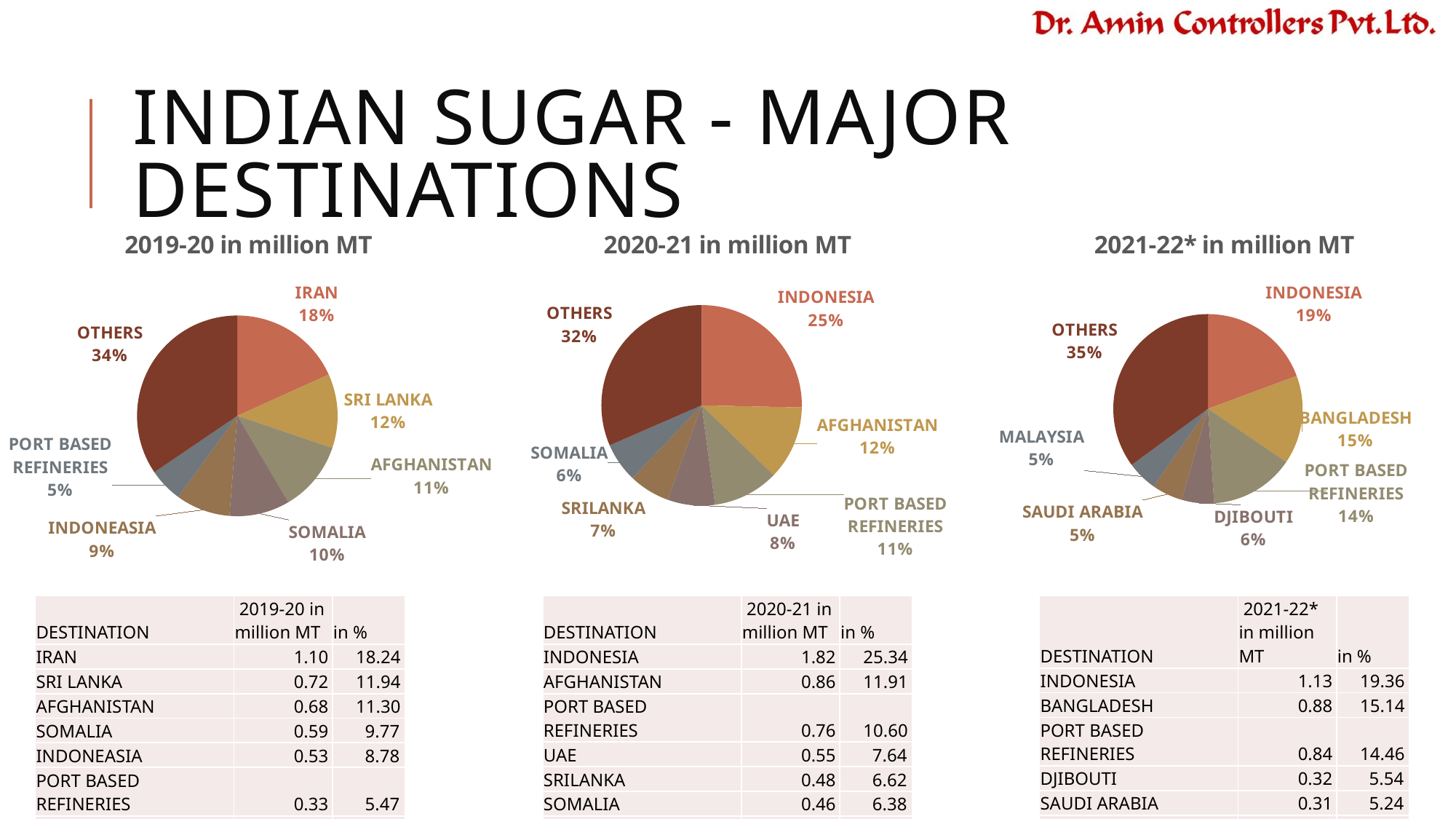
In the 2019-20 in million MT chart, which is larger: the Sri Lanka slice or the Somalia slice? SRI LANKA In the 2019-20 in million MT chart, which named destination (excluding Others) has the largest slice? IRAN In the 2019-20 in million MT chart, what share does Iran hold? 18% What type of chart is used for the 2021-22* in million MT data? Pie chart In the 2020-21 in million MT chart, what share does Indonesia hold? 25% In the 2021-22* in million MT chart, what share does Bangladesh hold? 15% How many pie charts are shown on the slide? 3 In the 2021-22* in million MT chart, what is the difference between the Indonesia share and the Port Based Refineries share? 5% In the 2020-21 in million MT chart, what is the difference between the UAE share and the Sri Lanka share? 1% In the 2021-22* in million MT chart, what share does Djibouti hold? 6% How many slices does the 2020-21 in million MT pie chart have? 7 In the 2020-21 in million MT chart, which slice is the smallest? SOMALIA